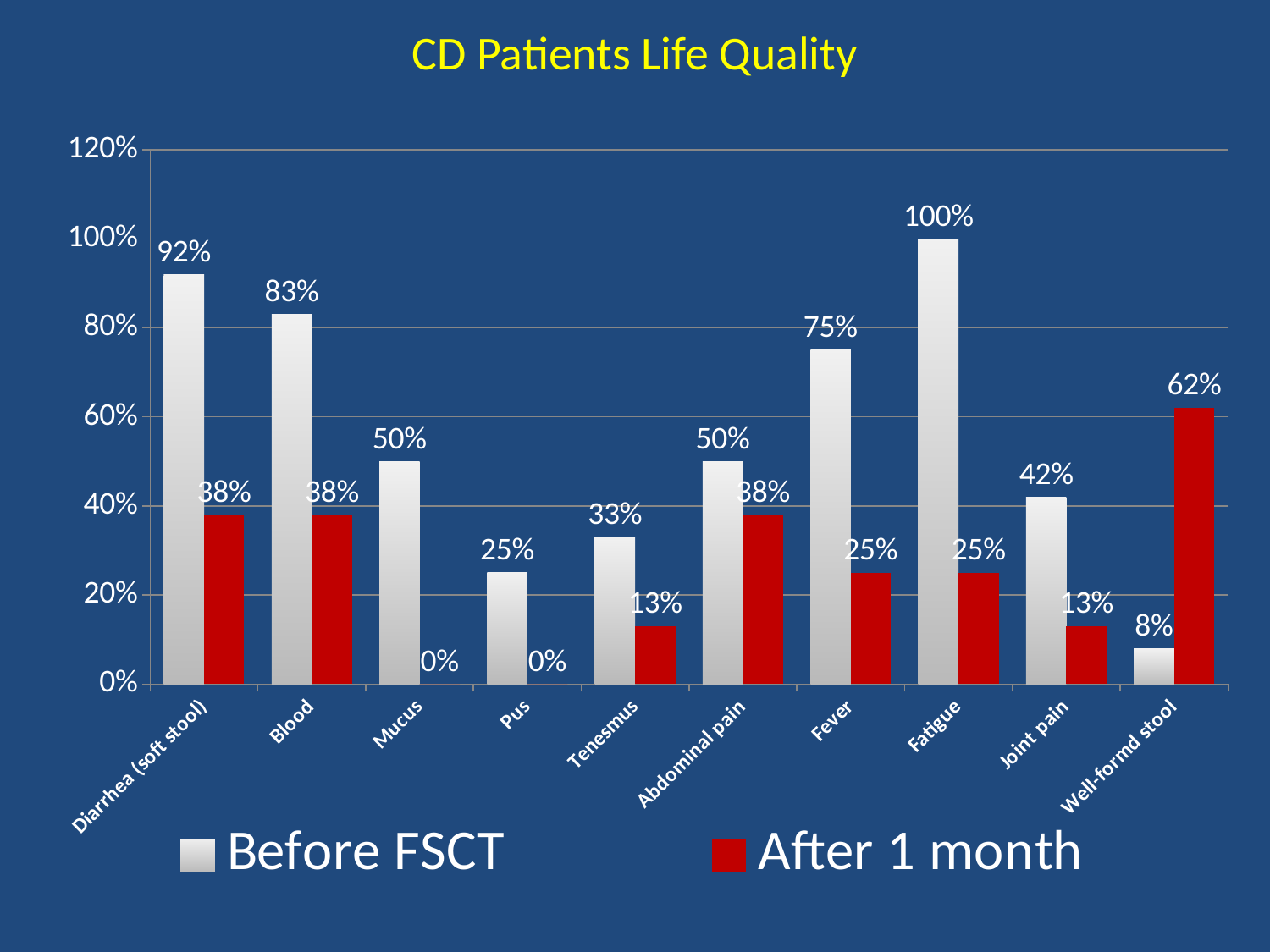
How many series does the legend list? 2 Which category has the highest After 1 month value? Well-formd stool Which category has the lowest Before FSCT value? Well-formd stool What is the After 1 month value for Tenesmus? 13% What is the After 1 month value for Well-formd stool? 62% What is the difference between the Before FSCT and After 1 month values for Diarrhea (soft stool)? 54% What is the title of the chart? CD Patients Life Quality How many categories are shown on the x axis? 10 What kind of chart is shown on the slide? Bar chart Which is larger for Fever: the Before FSCT value or the After 1 month value? Before FSCT Which category has the highest Before FSCT value? Fatigue What is the Before FSCT value for Fatigue? 100%